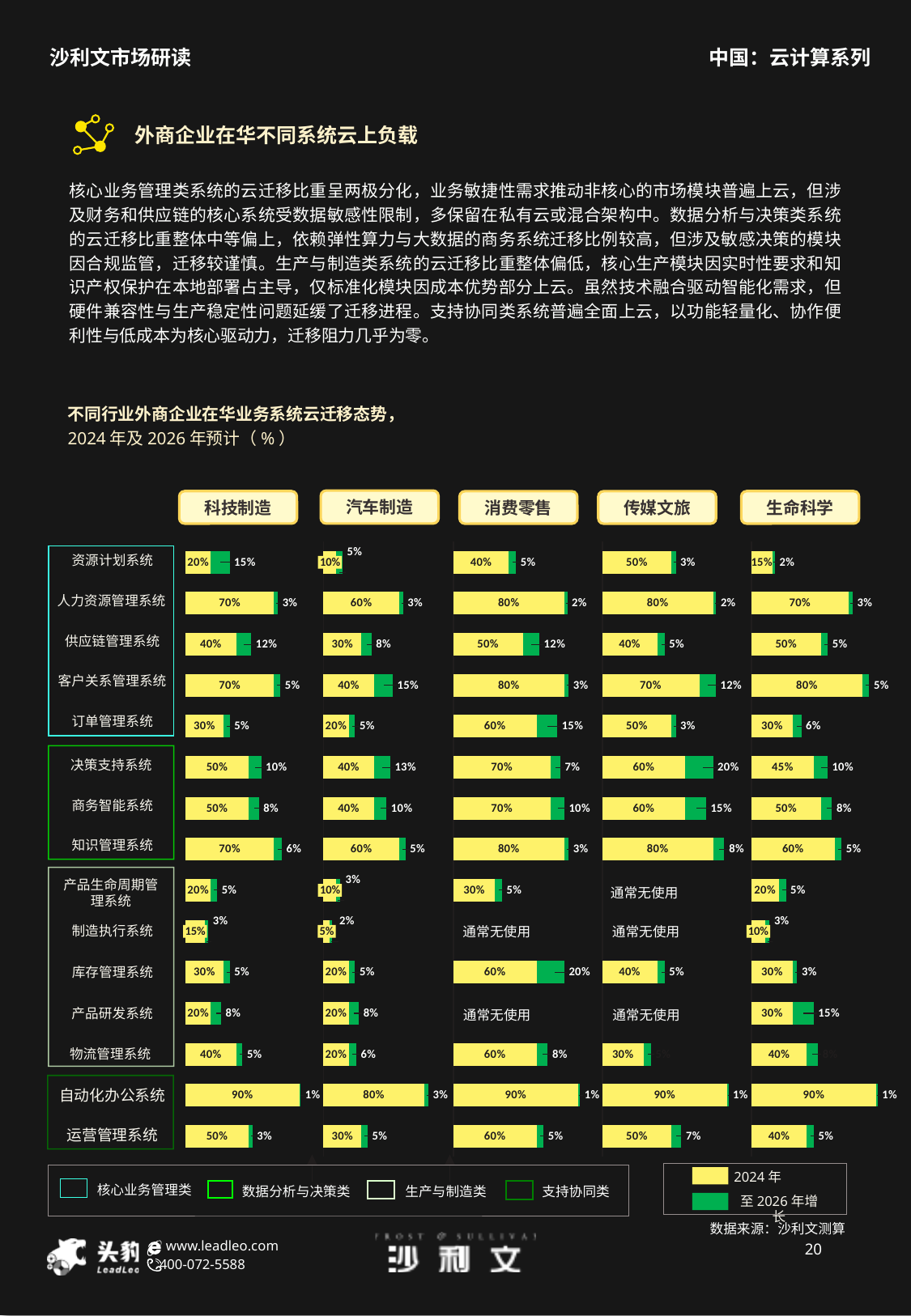
In the 汽车制造 column, which system has the highest 2024 value? 自动化办公系统 For 决策支持系统, which industry has the larger 至 2026 年增长 value: 传媒文旅 or 科技制造? 传媒文旅 In the 科技制造 column, what is the total of the 2024 value and the 至 2026 年增长 value for 资源计划系统? 35% What kind of chart is shown on the slide? Bar chart In the 汽车制造 column, which system has the lowest 2024 value? 制造执行系统 For 人力资源管理系统, how much higher is the 2024 value in 消费零售 than in 汽车制造? 20 percentage points How many industry columns does the chart show? 5 In the 科技制造 column, what is the 2024 value for 资源计划系统? 20% In the 生命科学 column, what is the 2024 value for 客户关系管理系统? 80% In the 消费零售 column, what is the 至 2026 年增长 value for 库存管理系统? 20% How many series does the legend list? 2 In the 汽车制造 column, what is the 2024 value for 人力资源管理系统? 60%